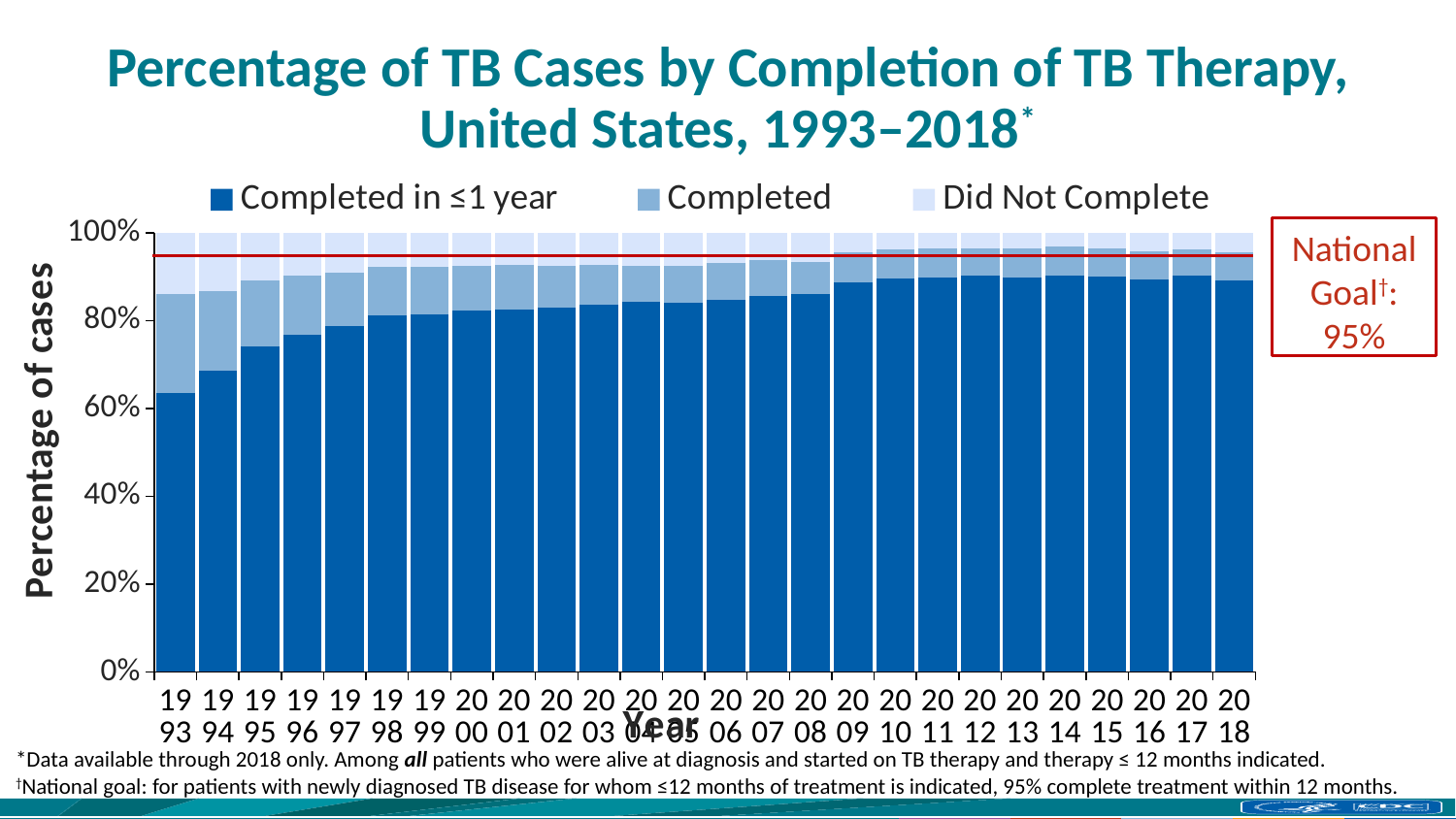
How many years are plotted along the x axis? 26 Does the 'Completed in ≤1 year' share generally rise or fall from 1993 to 2018? Rise Which year has the lowest 'Completed in ≤1 year' percentage? 1993 What are the three series named in the legend? Completed in ≤1 year, Completed, Did Not Complete What kind of chart is shown on the slide? Stacked bar chart Is the 'Completed in ≤1 year' value for 1993 greater or less than 60%? greater Which year has the larger 'Completed in ≤1 year' percentage, 1993 or 2018? 2018 Is the 'Completed in ≤1 year' value for 1993 greater or less than 80%? less What is the total height of each stacked bar on the chart? 100% Is the 'Completed in ≤1 year' value for 2018 greater or less than 80%? greater How many series does the legend list? 3 What is the National Goal shown in the box on the right of the chart? 95%